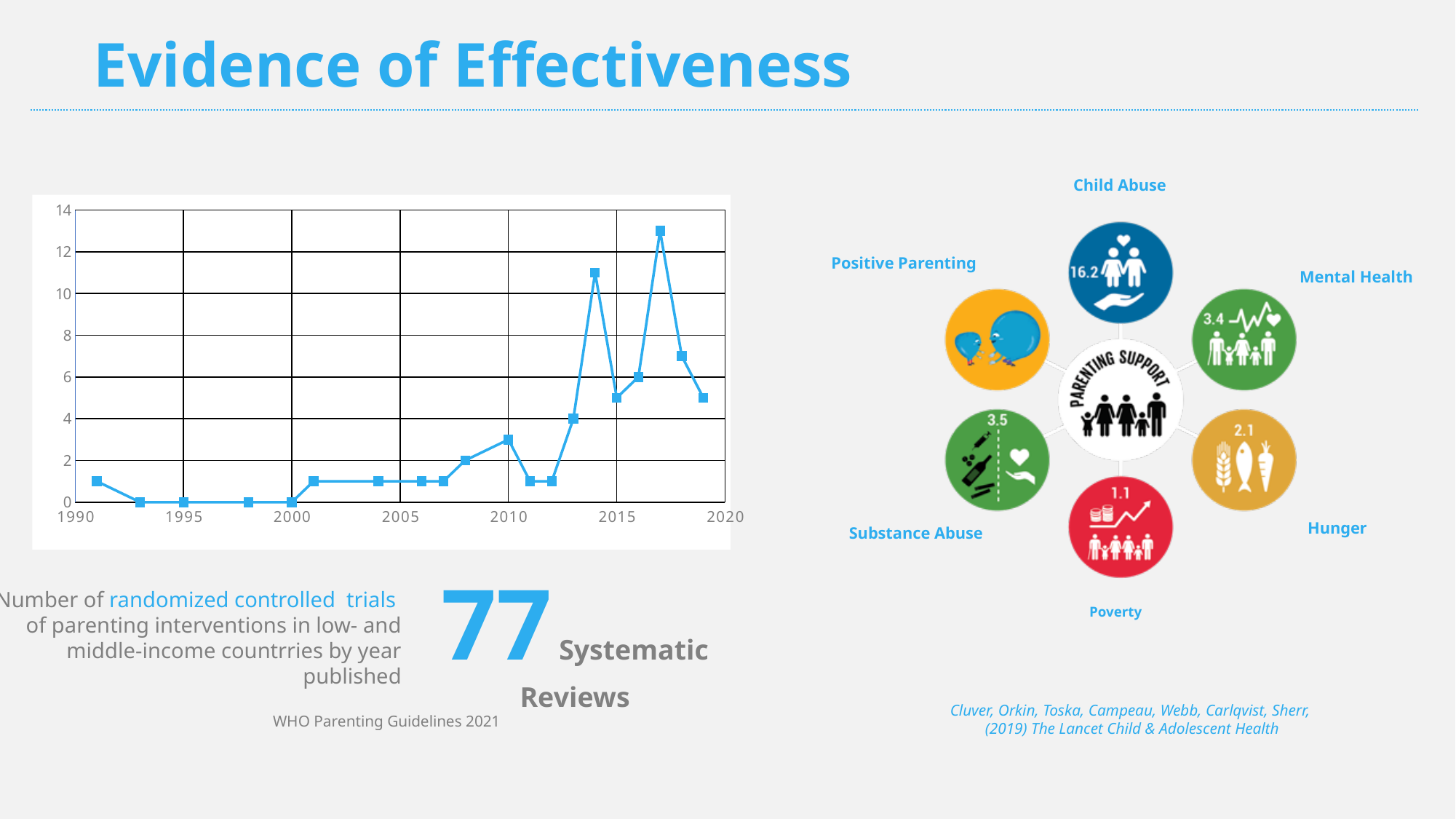
In the line chart, is the value at 2010 greater or less than 2? greater Overall, do the values in the line chart rise or fall from 1990 to 2020? rise In the line chart, is the value at 2010 greater or less than 4? less In the line chart, is the value at 2010 larger or smaller than the value at 2000? larger What kind of chart is shown on the left of the slide? line chart In the line chart, is the peak value greater or less than 12? greater What is the highest value shown on the y axis of the line chart? 14 In the line chart, what is the value at the year 2000? 0 In the line chart, what is the value at the year 1995? 0 What range of years does the x axis of the line chart cover? 1990 to 2020 In the line chart, is the highest point before or after 2015 on the x axis? after